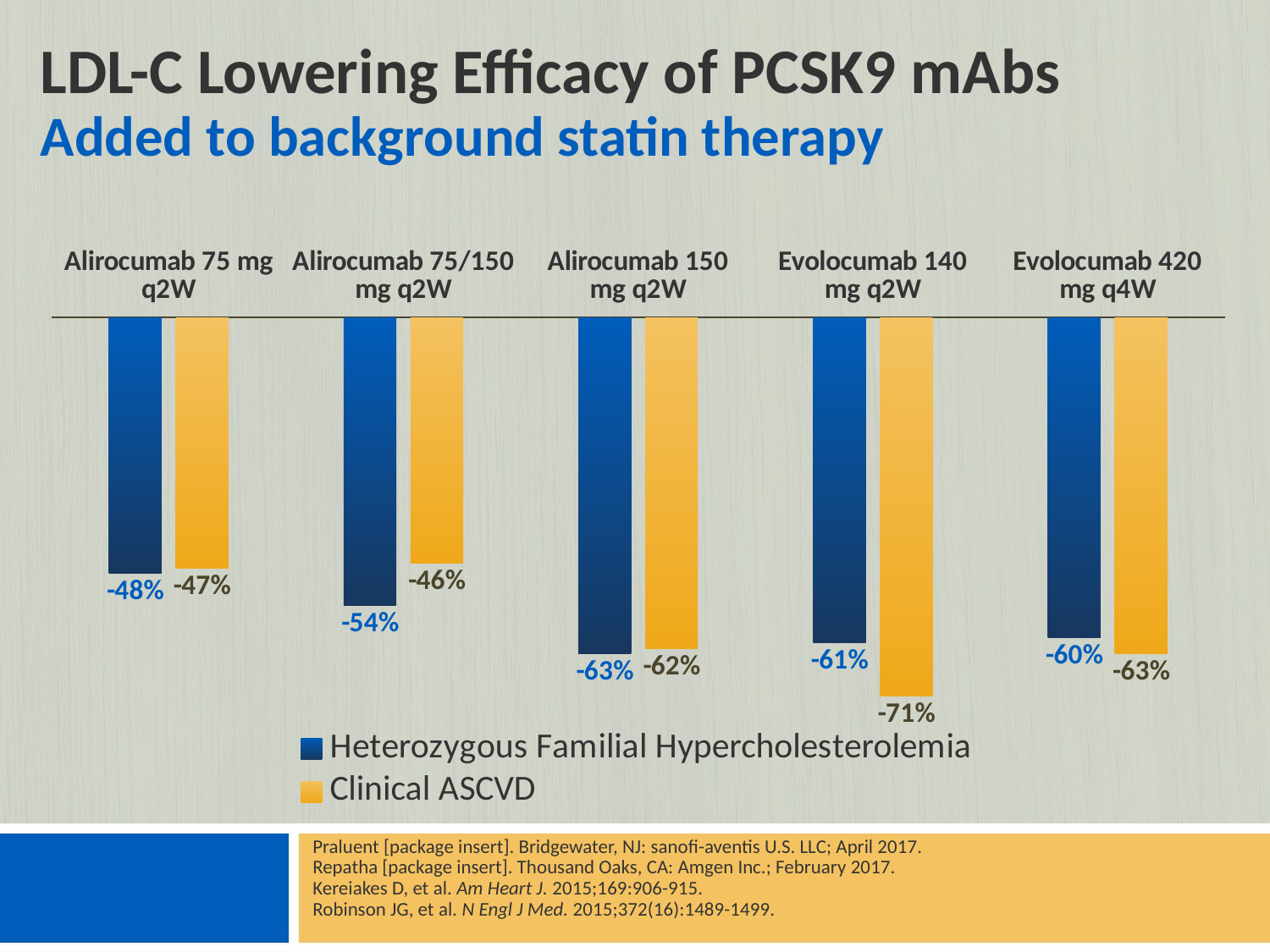
Which colour represents the Clinical ASCVD series in the legend? Yellow What value is shown for Evolocumab 420 mg q4W in the Heterozygous Familial Hypercholesterolemia series? -60% What is the difference in percentage points between the Heterozygous Familial Hypercholesterolemia and Clinical ASCVD values for Alirocumab 150 mg q2W? 1 percentage point What is the LDL-C reduction for Evolocumab 140 mg q2W in the Clinical ASCVD series? -71% Which regimen and series shows the largest LDL-C reduction on the chart? Evolocumab 140 mg q2W, Clinical ASCVD What kind of chart is shown on the slide? Bar chart Which regimen shows the smallest LDL-C reduction in the Clinical ASCVD series? Alirocumab 75/150 mg q2W How many series does the legend list? 2 What value is shown for Alirocumab 75/150 mg q2W in the Clinical ASCVD series? -46% What is the LDL-C reduction for Alirocumab 75 mg q2W in the Heterozygous Familial Hypercholesterolemia series? -48% How many dosing regimens are shown on the x axis? 5 For Evolocumab 140 mg q2W, which series shows the greater LDL-C reduction? Clinical ASCVD